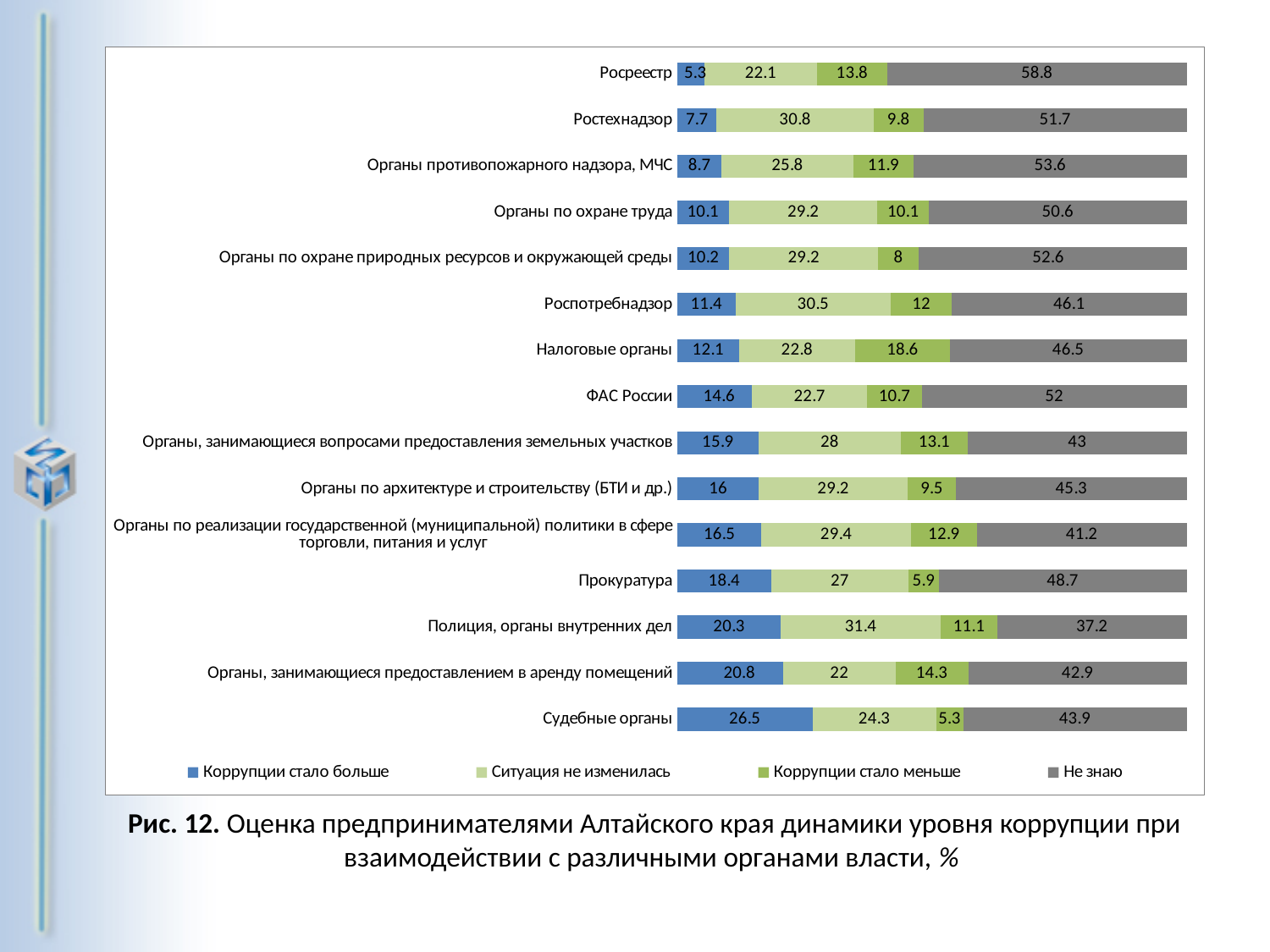
What is the value of "Коррупции стало меньше" for Налоговые органы? 18.6 How many series does the legend list? 4 What type of chart is shown on the slide? Stacked bar chart What is the value of "Не знаю" for Росреестр? 58.8 What is the difference between the "Коррупции стало больше" values for Судебные органы and Росреестр? 21.2 What is the figure number given in the caption below the chart? Рис. 12 Which is larger: the "Ситуация не изменилась" value for Ростехнадзор or for Росреестр? Ростехнадзор Which body has the highest value for "Коррупции стало больше"? Судебные органы What is the value of "Коррупции стало больше" for Полиция, органы внутренних дел? 20.3 Which body has the lowest value for "Не знаю"? Полиция, органы внутренних дел What is the total of the stacked bar for Росреестр? 100 How many government bodies (categories) are shown in the chart? 15